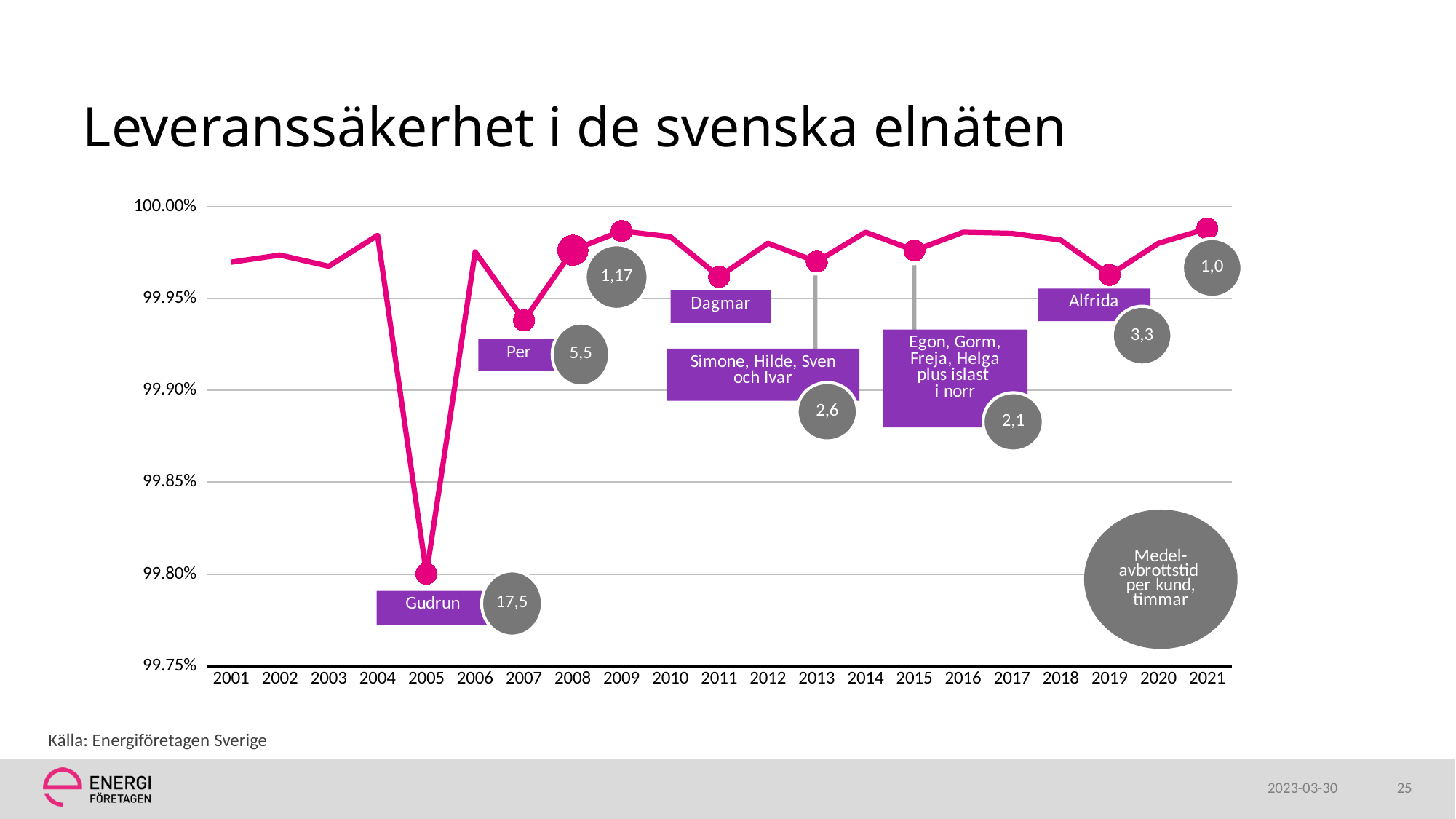
What kind of chart is shown on the slide? Line chart What average outage time per customer (hours) is shown for the storm Gudrun? 17,5 Is the value for 2007 greater or less than 99.90%? greater Which year has the lowest delivery reliability value in the chart? 2005 What average outage time per customer (hours) is shown for the storm Alfrida? 3,3 Which storm is labelled at the 2011 data point? Dagmar Which is higher, the value for 2005 or the value for 2006? 2006 Is the value for 2001 greater or less than 99.95%? greater According to the large grey circle, what do the grey circles in the chart represent? Medel-avbrottstid per kund, timmar Is the value for 2005 greater or less than 99.85%? less What average outage time per customer (hours) is shown for 2021? 1,0 How many years are shown on the x axis of the chart? 21